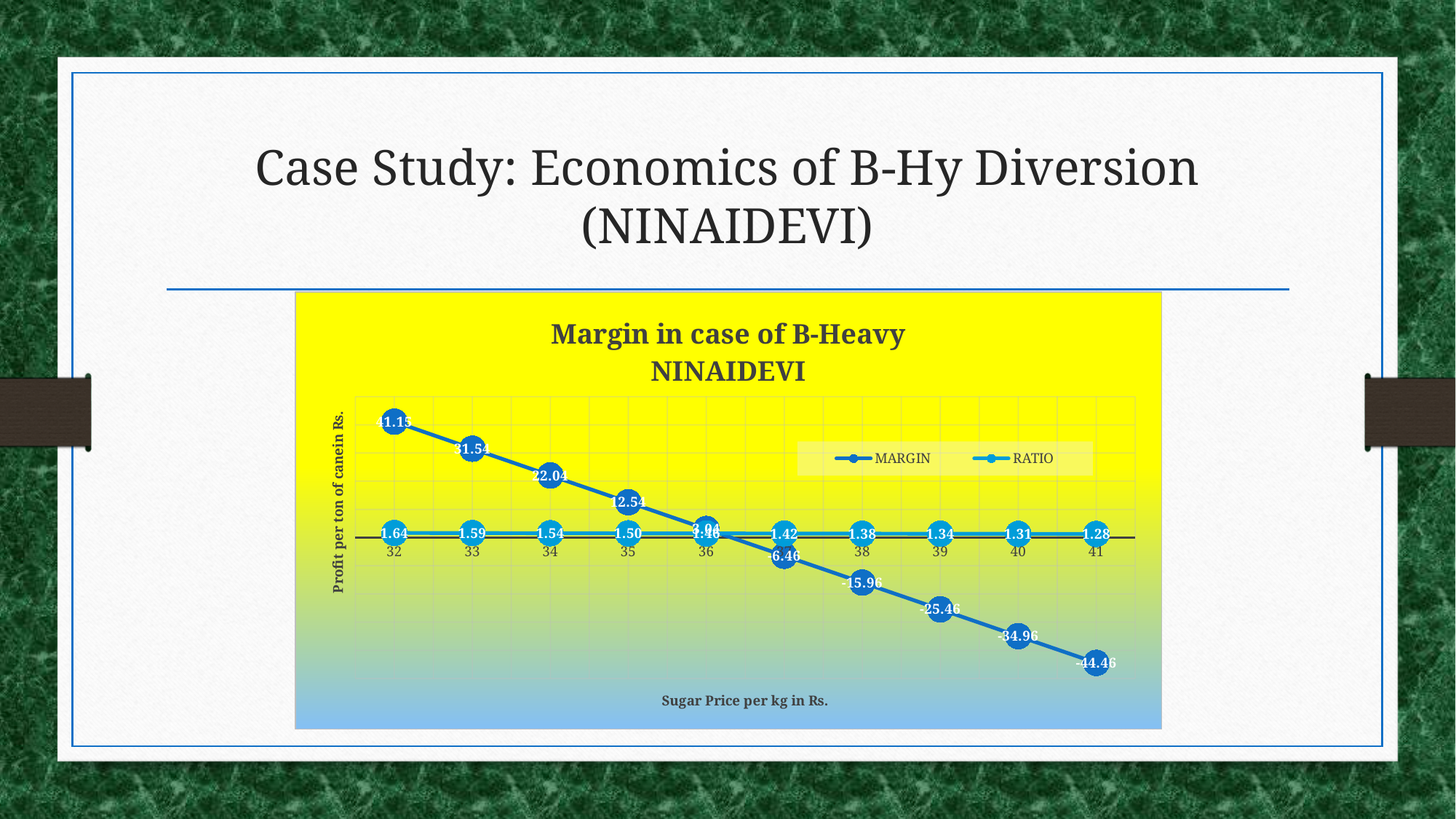
What is the MARGIN value at a sugar price of 33? 31.54 What is the RATIO value at a sugar price of 40? 1.31 Does the MARGIN series rise or fall as the sugar price increases? Fall How many series does the legend list? 2 At which sugar price is the MARGIN value lowest? 41 What is the difference between the MARGIN values at sugar prices 33 and 34? 9.50 How many sugar price points are plotted on the x axis? 10 What kind of chart is shown on the slide? Line chart Which has the larger RATIO value: sugar price 33 or sugar price 39? 33 What is the title of the x axis? Sugar Price per kg in Rs. What is the MARGIN value at a sugar price of 41? -44.46 What is the RATIO value at a sugar price of 32? 1.64